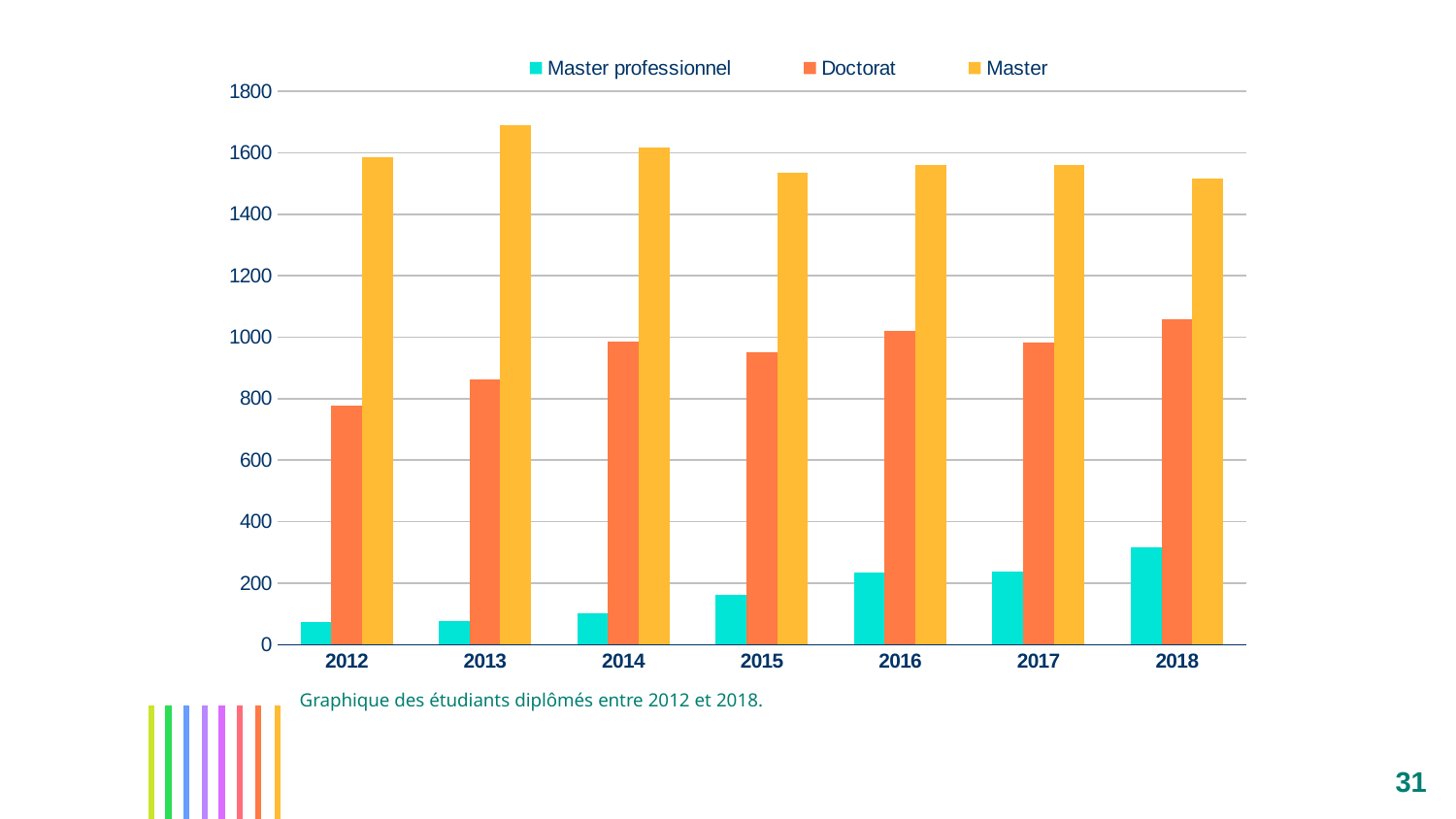
Is the Master value for 2015 greater or less than 1600? less Is the Master professionnel value for 2018 greater or less than 200? greater Does the Master professionnel series generally rise or fall from 2012 to 2018? rise In which year is the Master professionnel series highest? 2018 Which is larger in 2014, the Doctorat value or the Master professionnel value? Doctorat How many series does the legend list? 3 What kind of chart is shown on the slide? bar chart Is the Master value for 2013 greater or less than 1600? greater In which year is the Master series highest? 2013 In which year is the Doctorat series lowest? 2012 How many years are shown on the x axis? 7